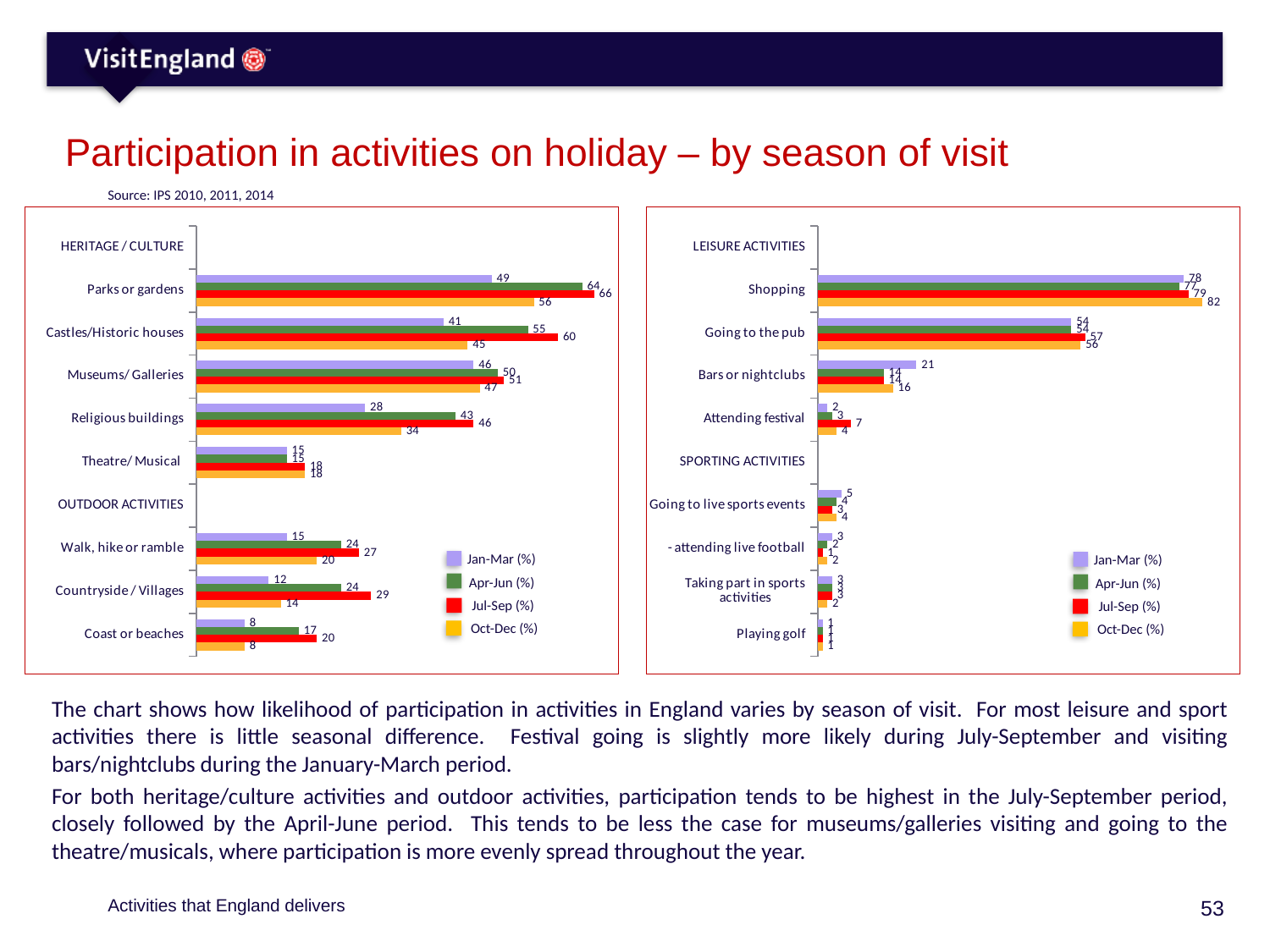
In the left chart, what is the difference between the Jul-Sep (%) and Jan-Mar (%) values for Coast or beaches? 12 How many series does the legend of the left chart list? 4 What type of chart is the right chart? Bar chart In the left chart, what is the Oct-Dec (%) value for Religious buildings? 34 In the left chart, which season has the highest value for Countryside / Villages? Jul-Sep (%) In the right chart, what is the difference between the Jan-Mar (%) and Apr-Jun (%) values for Bars or nightclubs? 7 In the left chart, what is the Jan-Mar (%) value for Castles/Historic houses? 41 In the right chart, which season has the highest value for Attending festival? Jul-Sep (%) In the left chart, which is larger for Walk, hike or ramble: the Apr-Jun (%) value or the Oct-Dec (%) value? Apr-Jun (%) In the left chart, what is the Jul-Sep (%) value for Parks or gardens? 66 In the right chart, what is the Oct-Dec (%) value for Shopping? 82 In the right chart, what is the Jan-Mar (%) value for Bars or nightclubs? 21